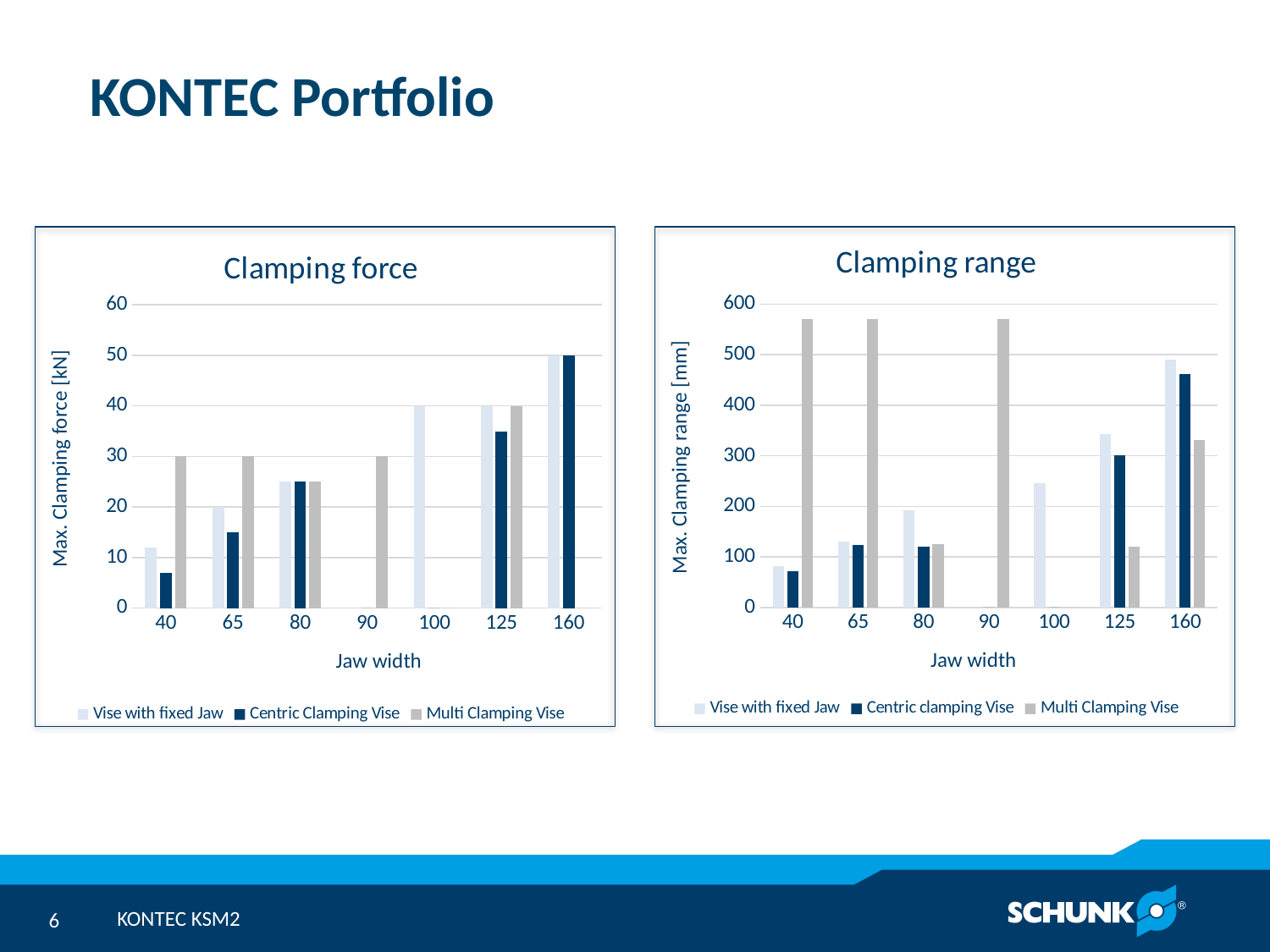
How many series does the legend of the "Clamping range" chart list? 3 In the "Clamping force" chart, does the Vise with fixed Jaw value rise or fall from jaw width 40 to jaw width 160? rise In the "Clamping range" chart, at which jaw width is the Vise with fixed Jaw value highest? 160 What is the y-axis title of the "Clamping range" chart? Max. Clamping range [mm] How many jaw width categories are shown on the x axis of the "Clamping force" chart? 7 In the "Clamping force" chart, what is the value for Vise with fixed Jaw at jaw width 160? 50 In the "Clamping force" chart, is the value for Centric Clamping Vise at jaw width 40 greater or less than 10? less What kind of chart is the "Clamping force" chart? bar chart In the "Clamping force" chart, at jaw width 125, which is larger: Vise with fixed Jaw or Centric Clamping Vise? Vise with fixed Jaw In the "Clamping range" chart, at jaw width 160, which is larger: Centric clamping Vise or Multi Clamping Vise? Centric clamping Vise In the "Clamping range" chart, is the value for Multi Clamping Vise at jaw width 40 greater or less than 500? greater